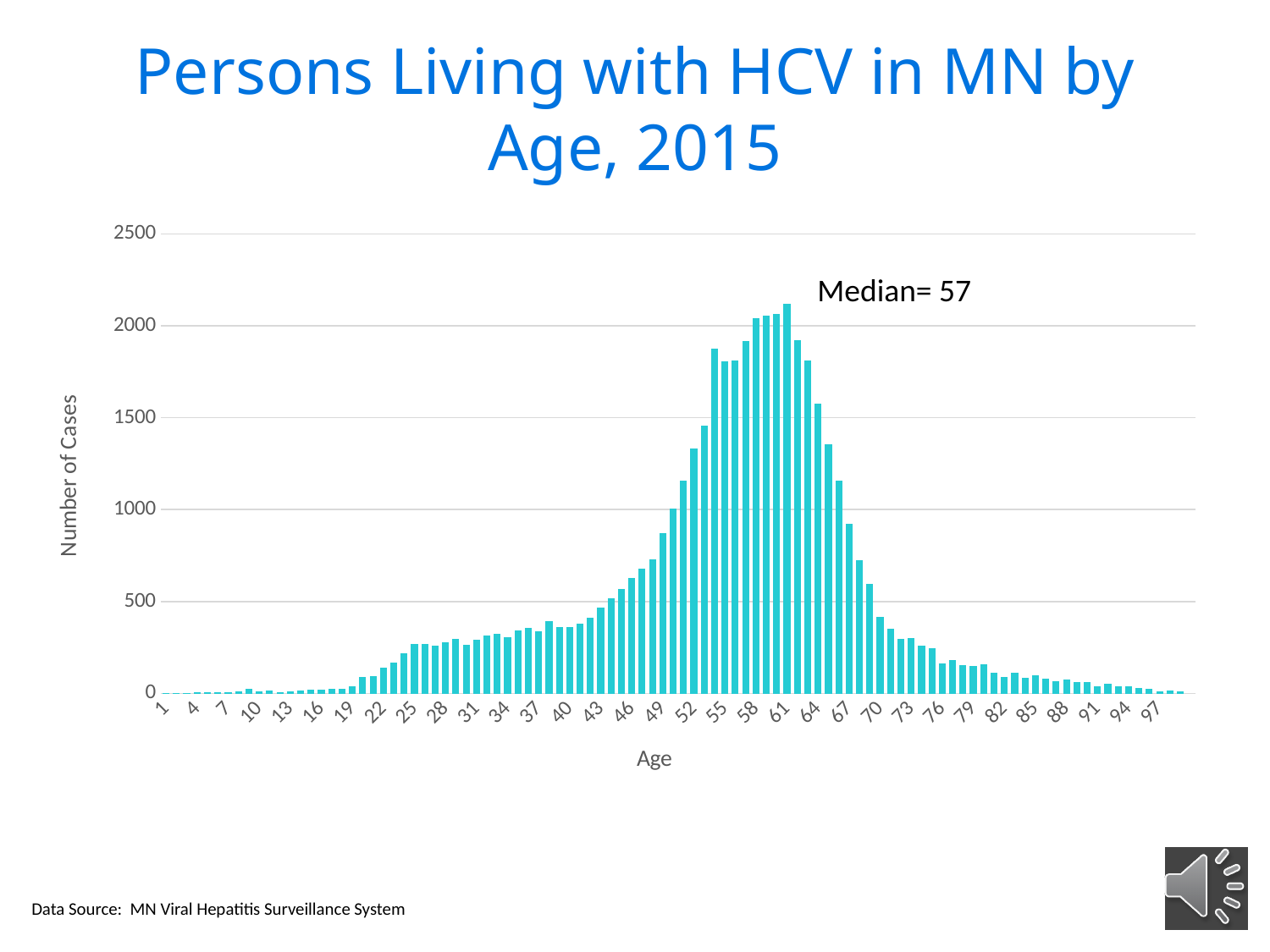
Is the number of cases for age 49 greater or less than 1000? less Is the number of cases for age 61 greater or less than 2000? greater Which has more cases, age 58 or age 67? age 58 Is the number of cases for age 52 greater or less than 1000? greater Do the number of cases rise or fall as age increases from 61 to 97? fall What kind of chart is shown on the slide? bar chart What is the title of the chart? Persons Living with HCV in MN by Age, 2015 Do the number of cases rise or fall as age increases from 40 to 55? rise What median value is annotated on the chart? 57